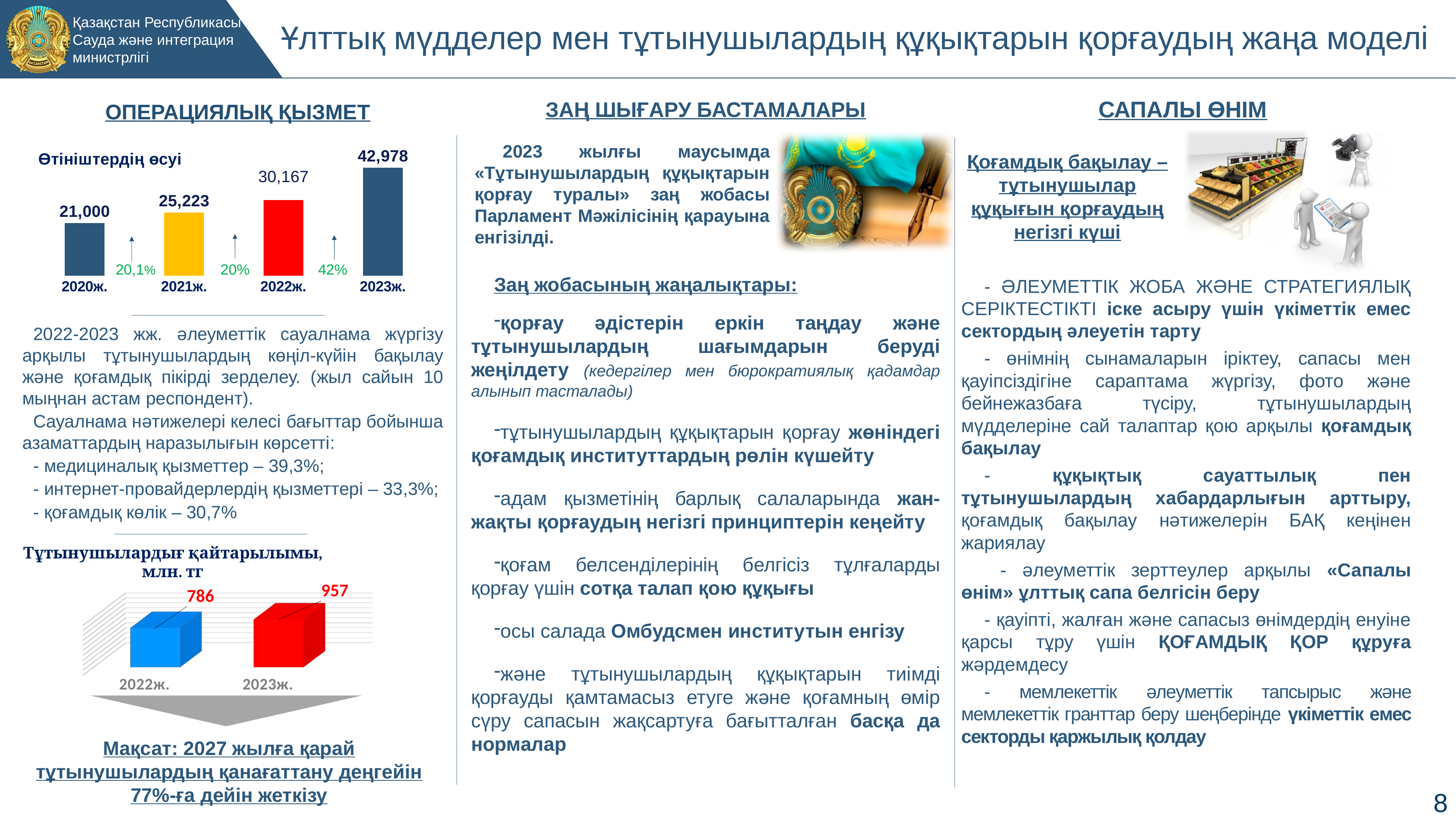
In the "Өтініштердің өсуі" chart, what growth percentage is shown between 2022ж. and 2023ж.? 42% In the "Тұтынушылардың қайтарылымы, млн. тг" chart, what is the value for 2023ж.? 957 In the "Өтініштердің өсуі" chart, which year has the highest value? 2023ж. In the "Өтініштердің өсуі" chart, do the values rise or fall from 2020ж. to 2023ж.? rise What kind of chart is the "Тұтынушылардың қайтарылымы, млн. тг" chart? bar chart In the "Өтініштердің өсуі" chart, what is the value for 2023ж.? 42,978 In the "Өтініштердің өсуі" chart, what is the difference between the values for 2021ж. and 2020ж.? 4,223 In the "Тұтынушылардың қайтарылымы, млн. тг" chart, what is the difference between the 2023ж. and 2022ж. values? 171 In the "Өтініштердің өсуі" chart, what is the value for 2022ж.? 30,167 In the "Өтініштердің өсуі" chart, how many years are shown? 4 In the "Өтініштердің өсуі" chart, what is the value for 2020ж.? 21,000 In the "Өтініштердің өсуі" chart, which year has the lowest value? 2020ж.